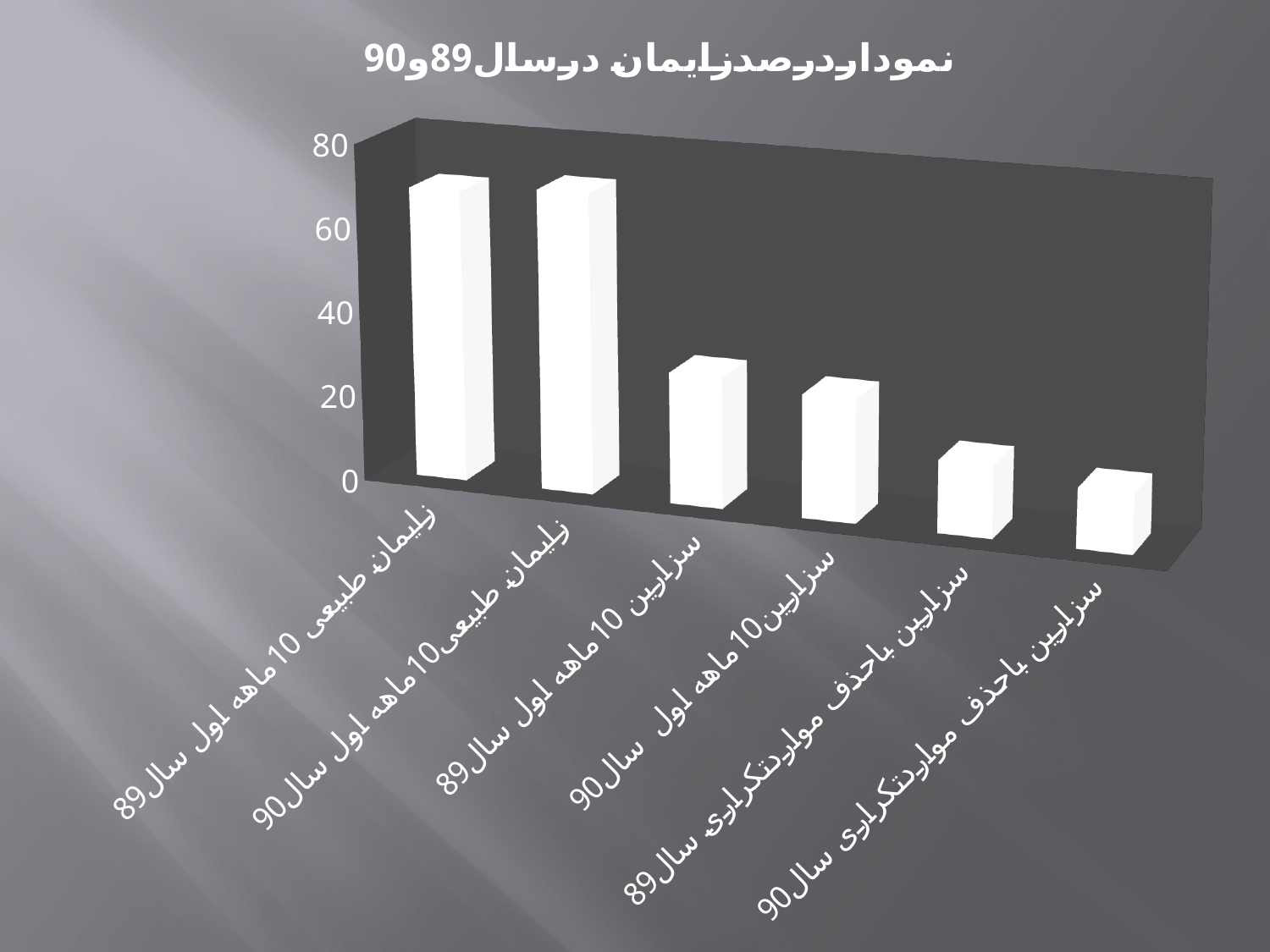
Is the value for سزارین 10 ماهه اول سال 89 greater or less than 60? less Is the value for زایمان طبیعی 10 ماهه اول سال 90 greater or less than 40? greater Is the value for زایمان طبیعی 10 ماهه اول سال 89 greater or less than 40? greater What is the highest value shown on the vertical axis? 80 How many categories (bars) are plotted in the chart? 6 What is the title of the chart? نموداردرصدزایمان درسال89و90 Which is larger: the value for سزارین 10 ماهه اول سال 90 or the value for سزارین با حذف موارد تکراری سال 90? سزارین 10 ماهه اول سال 90 What kind of chart is shown on the slide? bar chart Which is larger: the value for زایمان طبیعی 10 ماهه اول سال 89 or the value for سزارین 10 ماهه اول سال 89? زایمان طبیعی 10 ماهه اول سال 89 Do the bar values generally rise or fall from left to right across the chart? fall